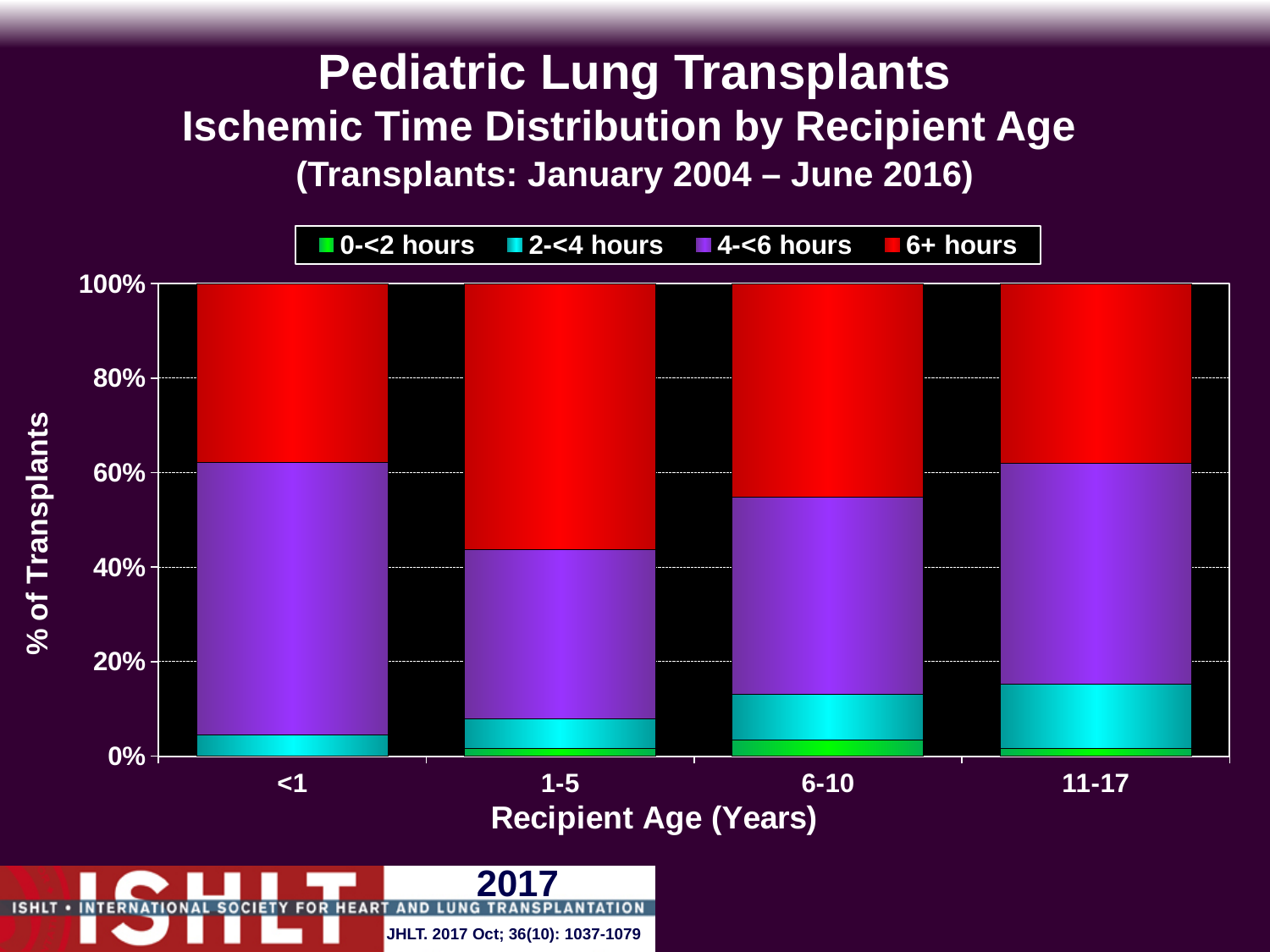
Is the 6+ hours share for the <1 age group greater or less than 50%? less Which age group has a larger 6+ hours share, 1-5 or 6-10? 1-5 Which recipient age group has the smallest share of transplants with 2-<4 hours ischemic time? <1 Is the 4-<6 hours share for the 1-5 age group greater or less than 50%? less Which recipient age group has the largest share of transplants with 6+ hours ischemic time? 1-5 Which series is shown in red in the legend? 6+ hours How many recipient age groups are shown on the x axis? 4 How many series does the legend list? 4 Is the 6+ hours share for the 1-5 age group greater or less than 50%? greater Which age group has a larger 4-<6 hours share, <1 or 1-5? <1 What is the label of the y axis? % of Transplants What kind of chart is shown on the slide? stacked bar chart